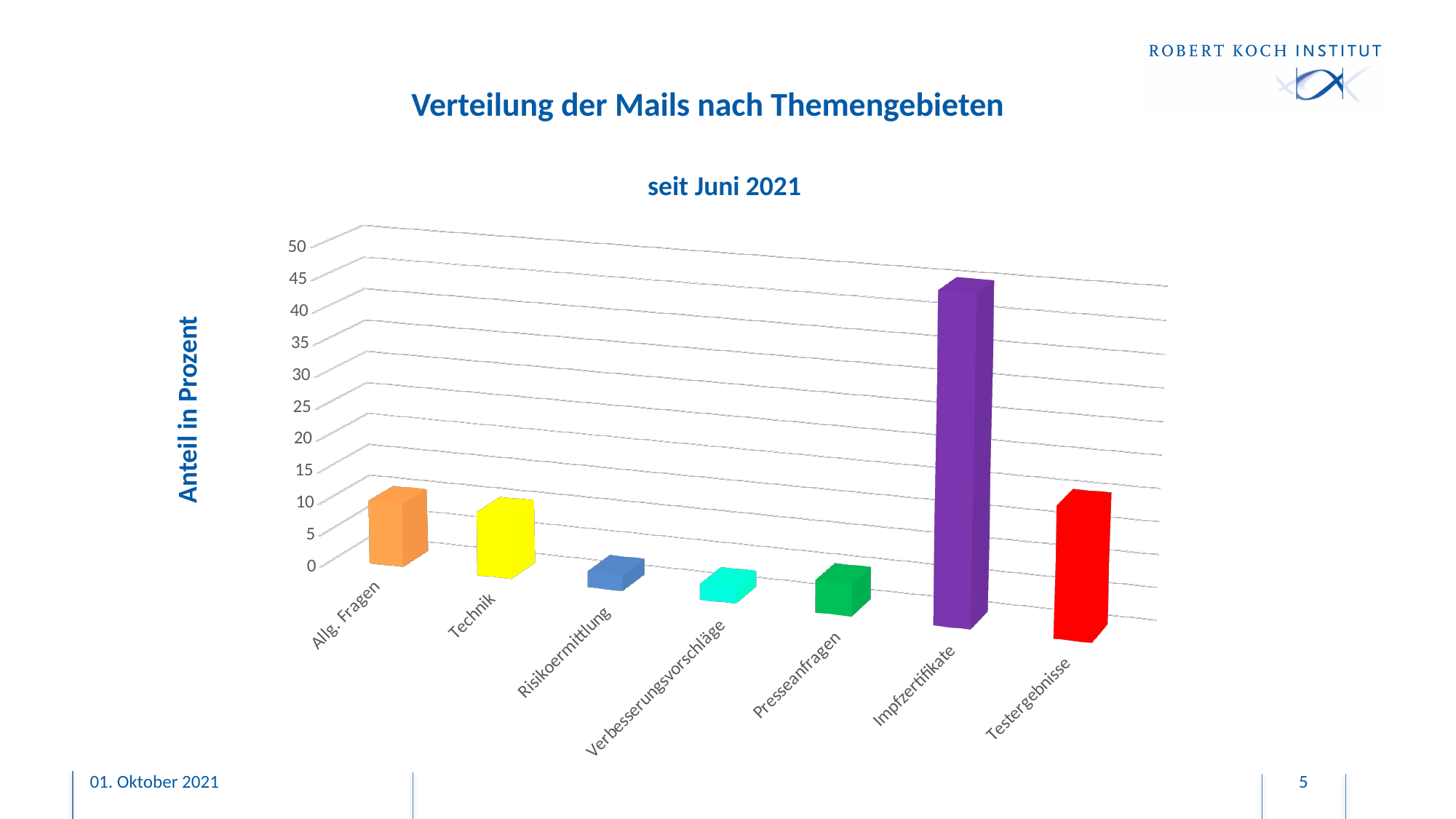
How many categories (Themengebiete) are shown on the x axis of the chart? 7 Is the value for Impfzertifikate greater or less than 30? greater Which is larger, the value for Impfzertifikate or the value for Testergebnisse? Impfzertifikate Which category has the highest bar in the chart? Impfzertifikate Is the value for Allg. Fragen greater or less than 20? less Is the value for Testergebnisse greater or less than 30? less What kind of chart is shown on the slide? bar chart Which is larger, the value for Allg. Fragen or the value for Risikoermittlung? Allg. Fragen Which is larger, the value for Technik or the value for Presseanfragen? Technik What is the subtitle shown directly above the chart? seit Juni 2021 What is the label of the vertical axis of the chart? Anteil in Prozent